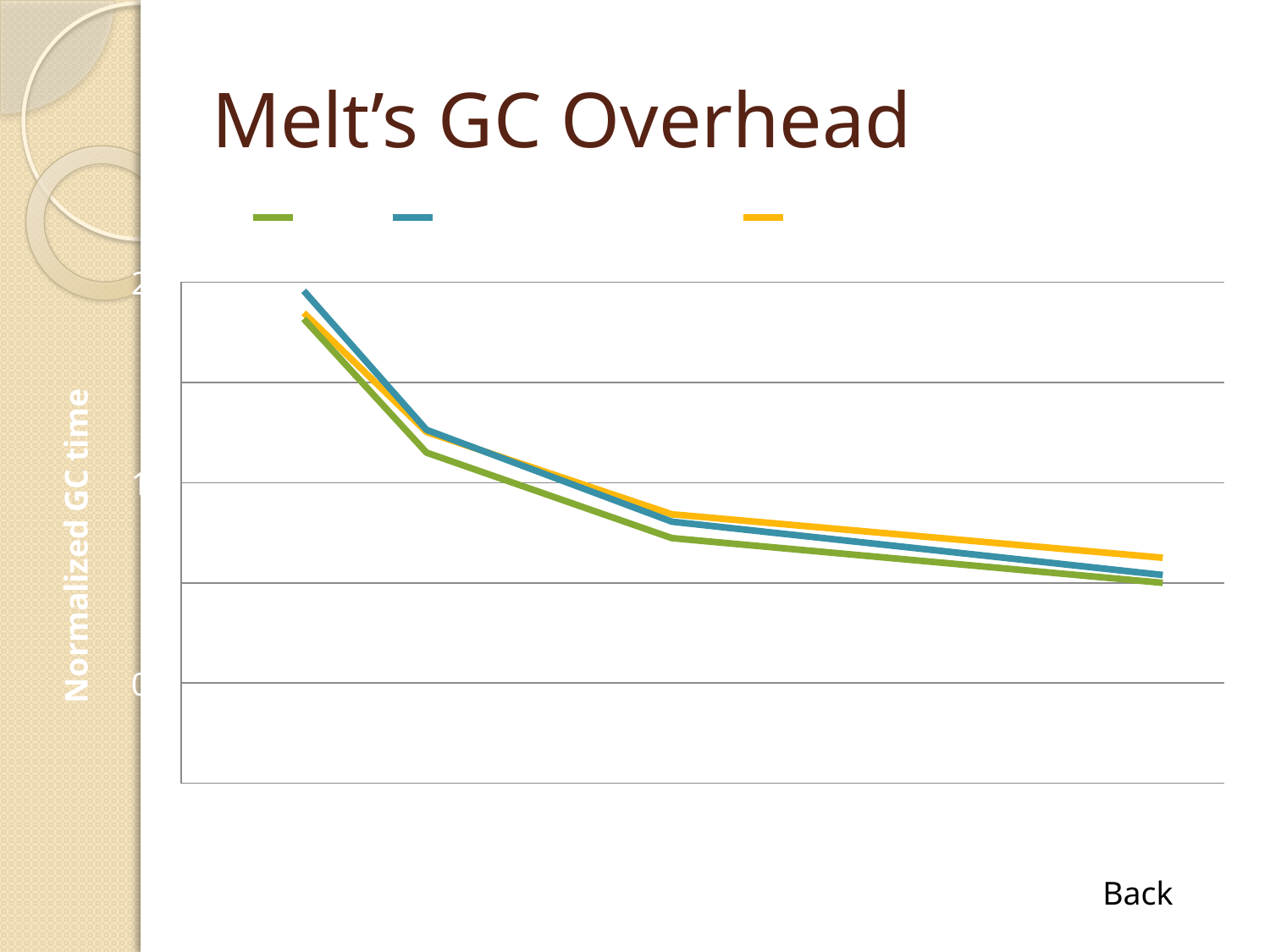
What is the label on the vertical axis? Normalized GC time Which point along the x axis has the highest values for all lines? the first (leftmost) point How many series does the legend list? 3 Do the plotted values rise or fall from left to right along the x axis? fall At the first (leftmost) point, are the values of the lines greater or less than 1? greater Which point along the x axis has the lowest values for all lines? the last (rightmost) point Is the value at the first point larger or smaller than the value at the second point? larger What kind of chart is shown on the slide? line chart How many data points does each line have? 4 What is the title of the chart? Melt's GC Overhead